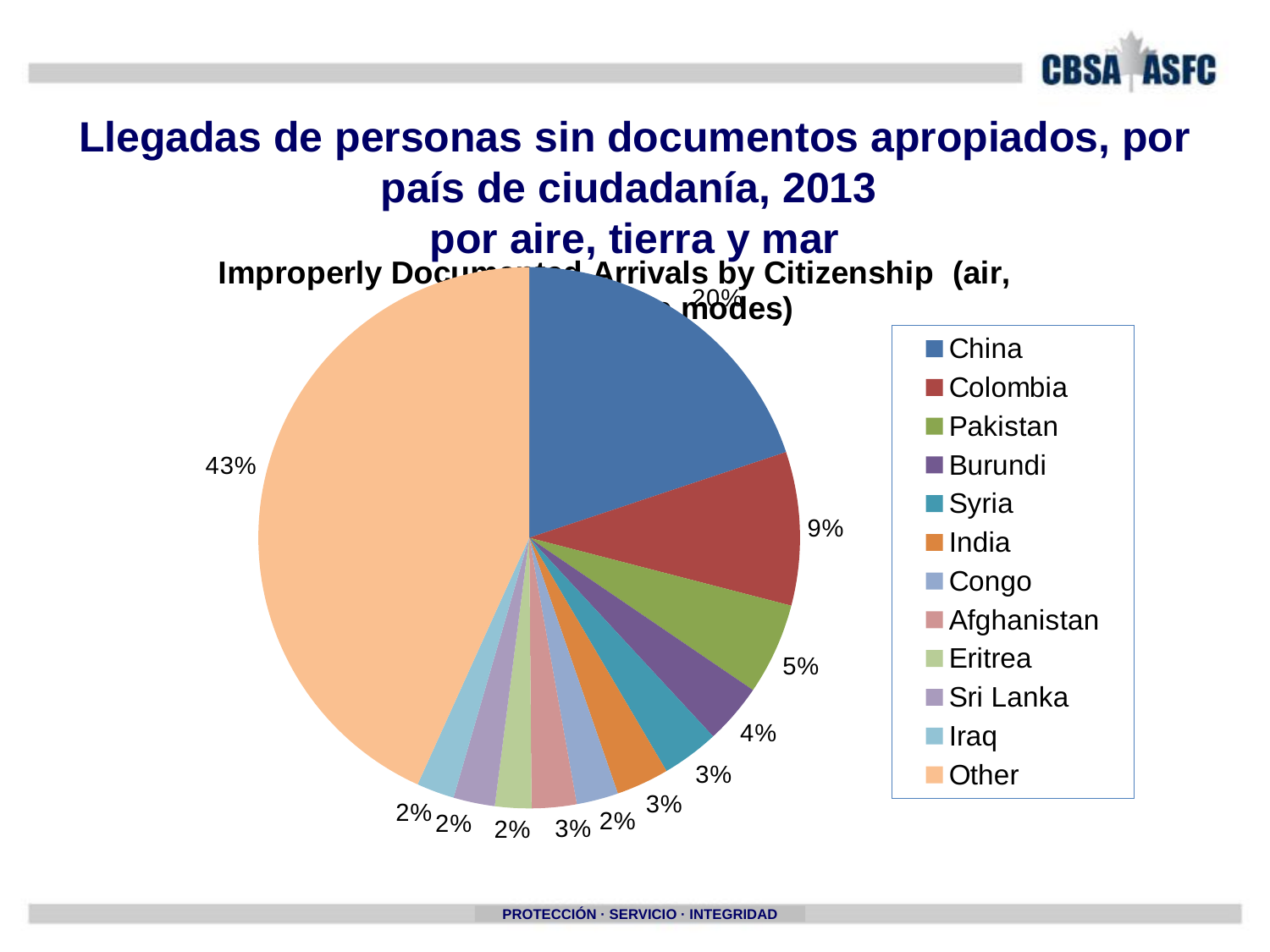
What share of the pie does the Other slice represent? 43% Which is larger, the slice for China or the slice for Colombia? China How many categories are shown in the pie chart? 12 Which category has the largest slice of the pie? Other What is the difference in percentage points between the Other slice and the China slice? 23 percentage points What kind of chart is shown on the slide? Pie chart What is the difference in percentage points between Colombia and Pakistan? 4 percentage points What is the value shown for China? 20% Which colour is used for the Other slice in the legend? Peach (light orange) What is the value shown for Burundi? 4% What is the value shown for Colombia? 9% What is the value shown for Pakistan? 5%